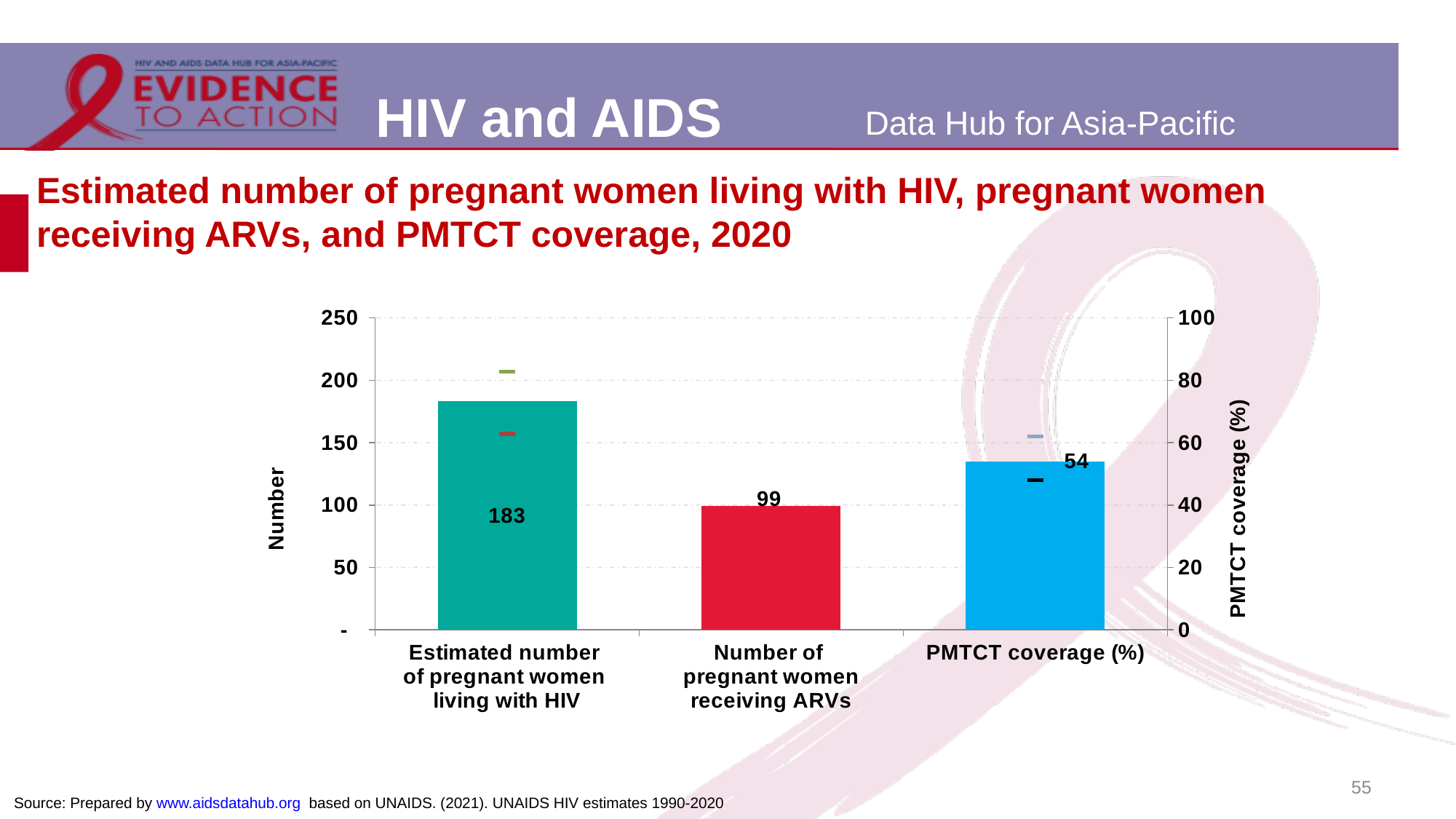
What is the number of pregnant women receiving ARVs shown on the chart? 99 How many categories are shown on the x axis of the chart? 3 Which category has the tallest bar on the chart? Estimated number of pregnant women living with HIV Which category has the shortest bar on the chart? Number of pregnant women receiving ARVs Which is larger: the estimated number of pregnant women living with HIV or the number of pregnant women receiving ARVs? Estimated number of pregnant women living with HIV Is the value for the estimated number of pregnant women living with HIV greater or less than 150? greater What is the difference between the estimated number of pregnant women living with HIV and the number of pregnant women receiving ARVs? 84 What is the title of the left vertical axis of the chart? Number What is the title of the right vertical axis of the chart? PMTCT coverage (%) What kind of chart is shown on the slide? Bar chart What is the estimated number of pregnant women living with HIV shown on the chart? 183 What is the PMTCT coverage (%) value shown on the chart? 54